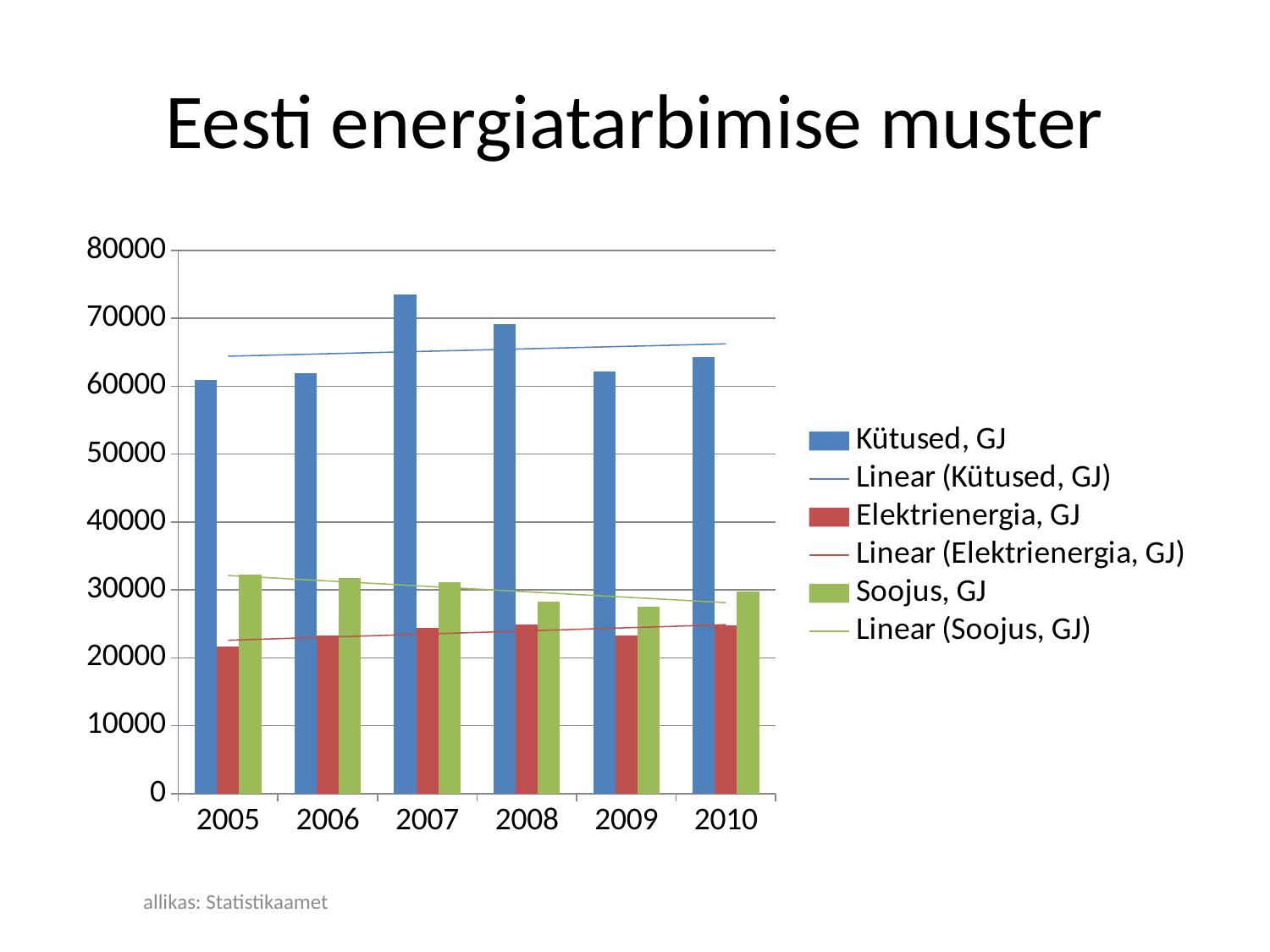
In which year is the value for Kütused, GJ the highest? 2007 In which year is the value for Elektrienergia, GJ the lowest? 2005 How many years are shown on the x axis of the chart? 6 Which is larger for Kütused, GJ: the value in 2007 or the value in 2008? 2007 What kind of chart is shown on the slide? bar chart Does the linear trendline for Soojus, GJ rise or fall from 2005 to 2010? fall How many entries does the chart's legend list? 6 Is the value for Soojus, GJ in 2009 greater or less than 30000? less Which is larger in 2010: Soojus, GJ or Elektrienergia, GJ? Soojus, GJ What is the title of the slide's chart? Eesti energiatarbimise muster Is the value for Kütused, GJ in 2007 greater or less than 70000? greater Is the value for Soojus, GJ in 2005 greater or less than 30000? greater